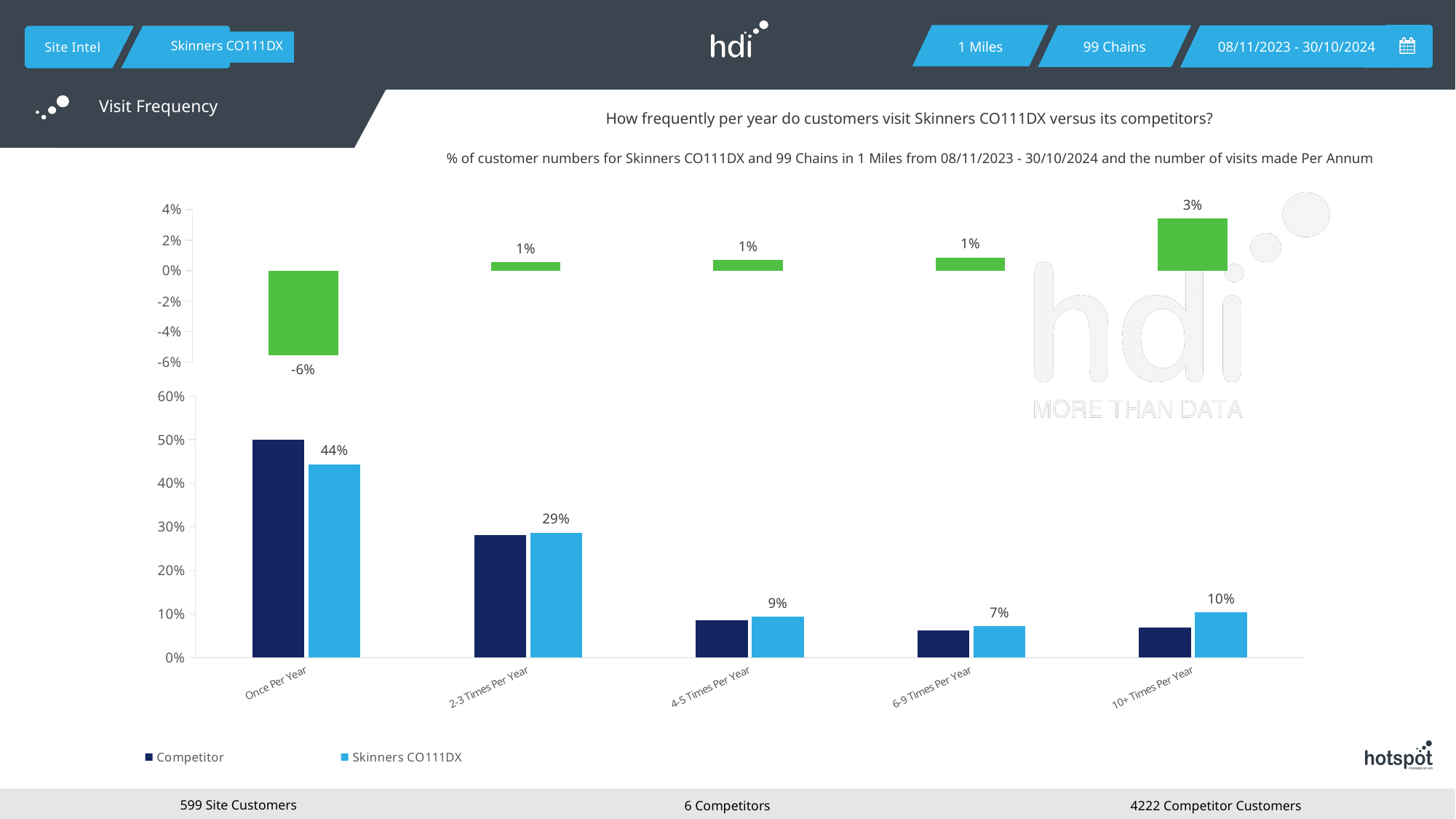
In the bottom bar chart, is the Competitor value for Once Per Year greater or less than 40%? greater How many series does the legend of the bottom bar chart list? 2 In the bottom bar chart, what is the difference between the Skinners CO111DX values for Once Per Year and 2-3 Times Per Year? 15% In the bottom bar chart, is the Competitor value for 4-5 Times Per Year greater or less than 10%? less In the bottom bar chart, what is the value for Skinners CO111DX in the 2-3 Times Per Year category? 29% In the bottom bar chart, which is larger for 2-3 Times Per Year: the Competitor bar or the Skinners CO111DX bar? Skinners CO111DX In the top green bar chart, which category has the highest value? 10+ Times Per Year In the bottom bar chart, what is the value for Skinners CO111DX in the Once Per Year category? 44% In the bottom bar chart, what is the value for Skinners CO111DX in the 10+ Times Per Year category? 10% In the top green bar chart, what is the value for the Once Per Year category? -6% In the bottom bar chart, which category has the lowest Skinners CO111DX value? 6-9 Times Per Year In the bottom bar chart, which category has the highest Skinners CO111DX value? Once Per Year